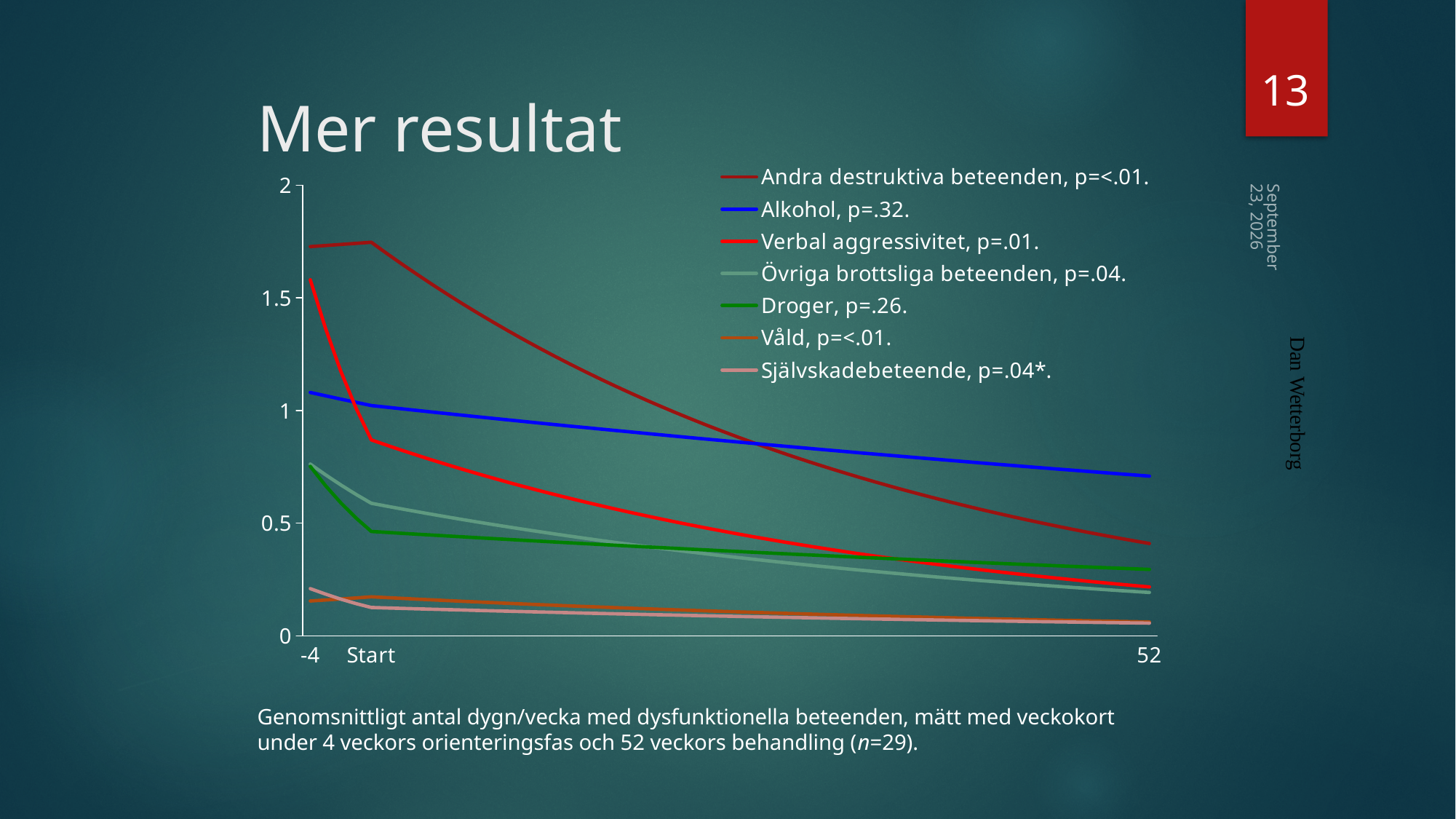
What kind of chart is shown on the slide? line chart Is the value for Andra destruktiva beteenden at -4 greater or less than 1.5? greater How many series does the legend list? 7 Does the Andra destruktiva beteenden line rise or fall from Start to 52? fall Which series has the highest value at 52? Alkohol At 52, which is larger: Alkohol or Verbal aggressivitet? Alkohol Is the value for Verbal aggressivitet at 52 greater or less than 0.5? less Is the value for Alkohol at 52 greater or less than 1? less What p-value does the legend give for Alkohol? p=.32 What is the highest tick value shown on the y axis? 2 Which series has the highest value at -4? Andra destruktiva beteenden